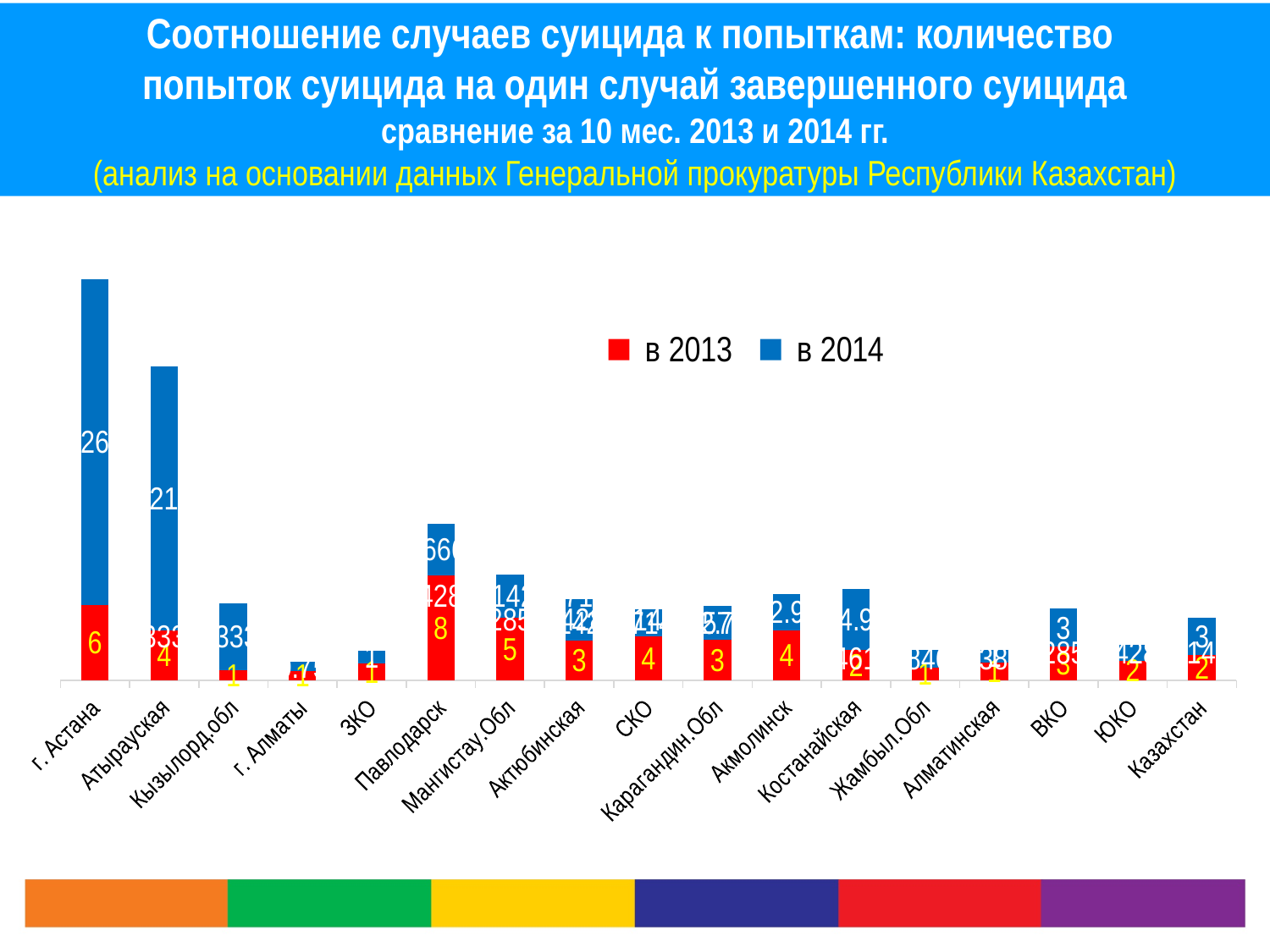
How many series does the legend list? 2 What is the value for г. Астана in the series в 2013? 6 What kind of chart is shown on the slide? stacked bar chart What is the total of the stacked bar for г. Астана? 32 Which category has the highest value in the series в 2014? г. Астана What is the value for г. Астана in the series в 2014? 26 How many categories are shown along the x axis? 17 What are the two series named in the legend? в 2013 and в 2014 What is the value for Атырауская in the series в 2013? 4 Which category has the highest value in the series в 2013? Павлодарск What is the value for Атырауская in the series в 2014? 21 What is the difference between the в 2014 and в 2013 values for г. Астана? 20